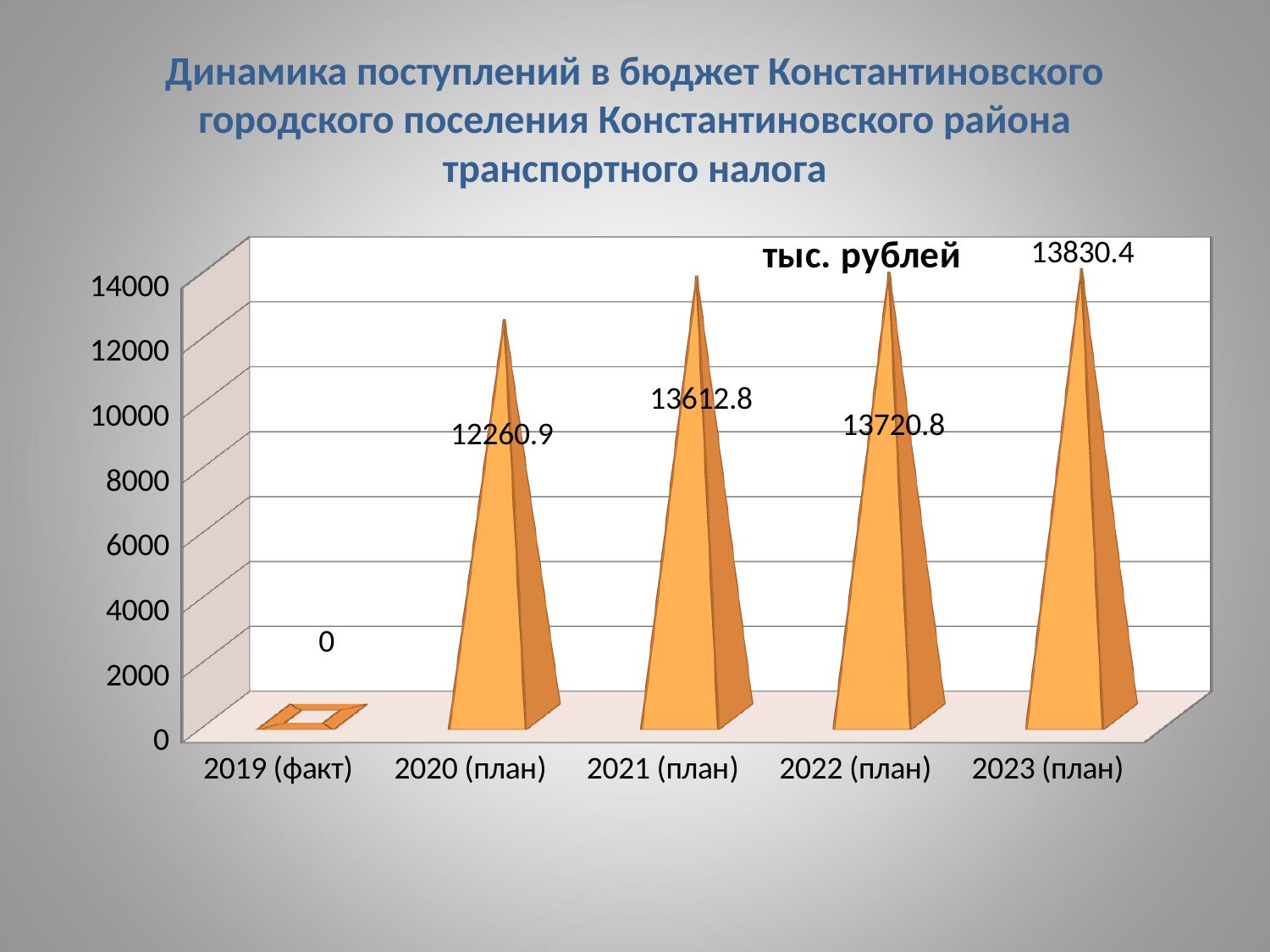
Is the value for 2020 (план) greater or less than 10000? greater What is the difference between the values for 2022 (план) and 2021 (план)? 108 What is the difference between the values for 2023 (план) and 2020 (план)? 1569.5 Do the values rise or fall from 2020 (план) to 2023 (план)? rise What is the value for 2022 (план)? 13720.8 In what units are the values on the chart expressed? тыс. рублей Which category has the highest value? 2023 (план) Which is larger, the value for 2021 (план) or the value for 2020 (план)? 2021 (план) What is the value for 2020 (план)? 12260.9 What is the value for 2019 (факт)? 0 Which category has the lowest value? 2019 (факт) How many categories are shown on the x axis? 5